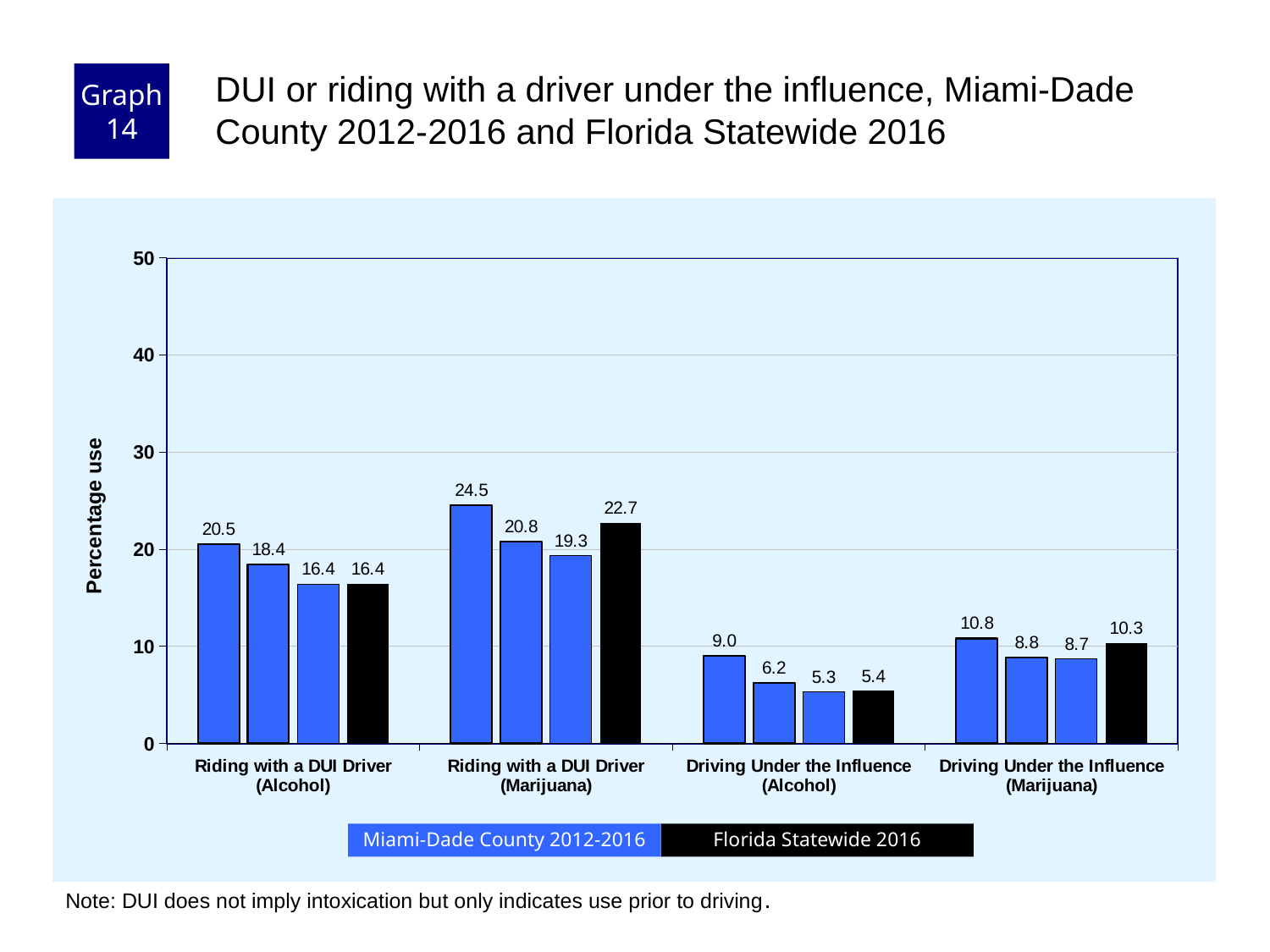
Within the Riding with a DUI Driver (Alcohol) category, do the Miami-Dade County bars rise or fall from left to right? fall What is the Florida Statewide 2016 value for Riding with a DUI Driver (Marijuana)? 22.7 What kind of chart is shown on the slide? bar chart What is the value of the first (leftmost) Miami-Dade County bar for Driving Under the Influence (Alcohol)? 9.0 How many series does the legend list? 2 What is the Florida Statewide 2016 value for Driving Under the Influence (Alcohol)? 5.4 Is the Florida Statewide 2016 value for Riding with a DUI Driver (Marijuana) greater or less than 20? greater Which is larger for Florida Statewide 2016: Driving Under the Influence (Marijuana) or Driving Under the Influence (Alcohol)? Driving Under the Influence (Marijuana) What is the difference between the Florida Statewide 2016 values for Riding with a DUI Driver (Marijuana) and Riding with a DUI Driver (Alcohol)? 6.3 Which category contains the tallest bar on the chart? Riding with a DUI Driver (Marijuana) How many categories are shown on the x axis? 4 What is the lowest value shown on the chart? 5.3